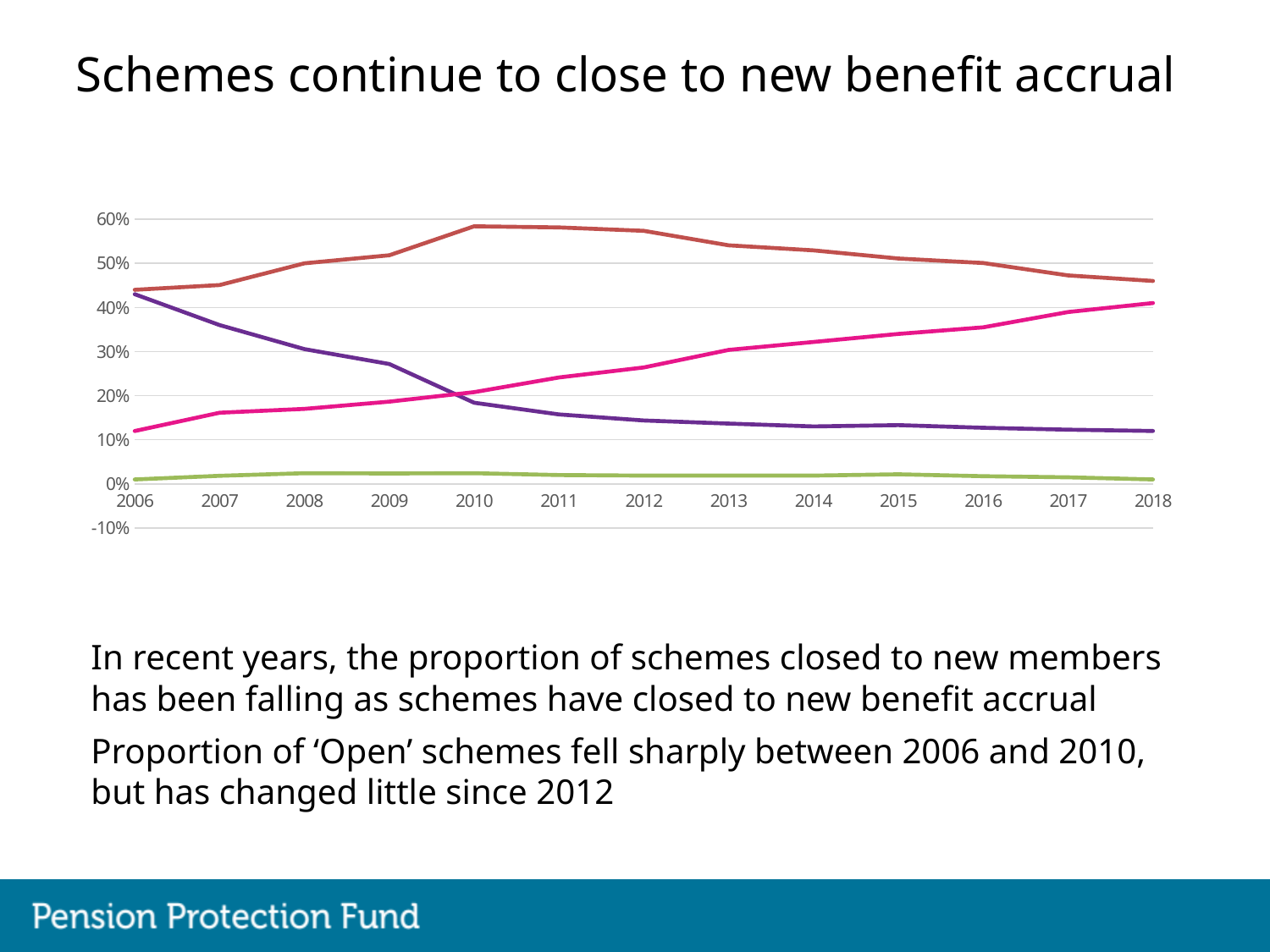
Is the value of the pink line in 2006 greater or less than 20%? less Which line is lowest across all years shown? the green line Is the value of the orange line in 2010 greater or less than 50%? greater How many years are shown along the x axis of the chart? 13 In 2006, which is higher: the purple line or the pink line? the purple line Does the pink line rise or fall from 2006 to 2018? rises How many lines are plotted on the chart? 4 Does the purple line rise or fall from 2006 to 2018? falls Which line is highest in 2010? the orange line Is the value of the purple line in 2018 greater or less than 20%? less What kind of chart is shown on the slide? line chart